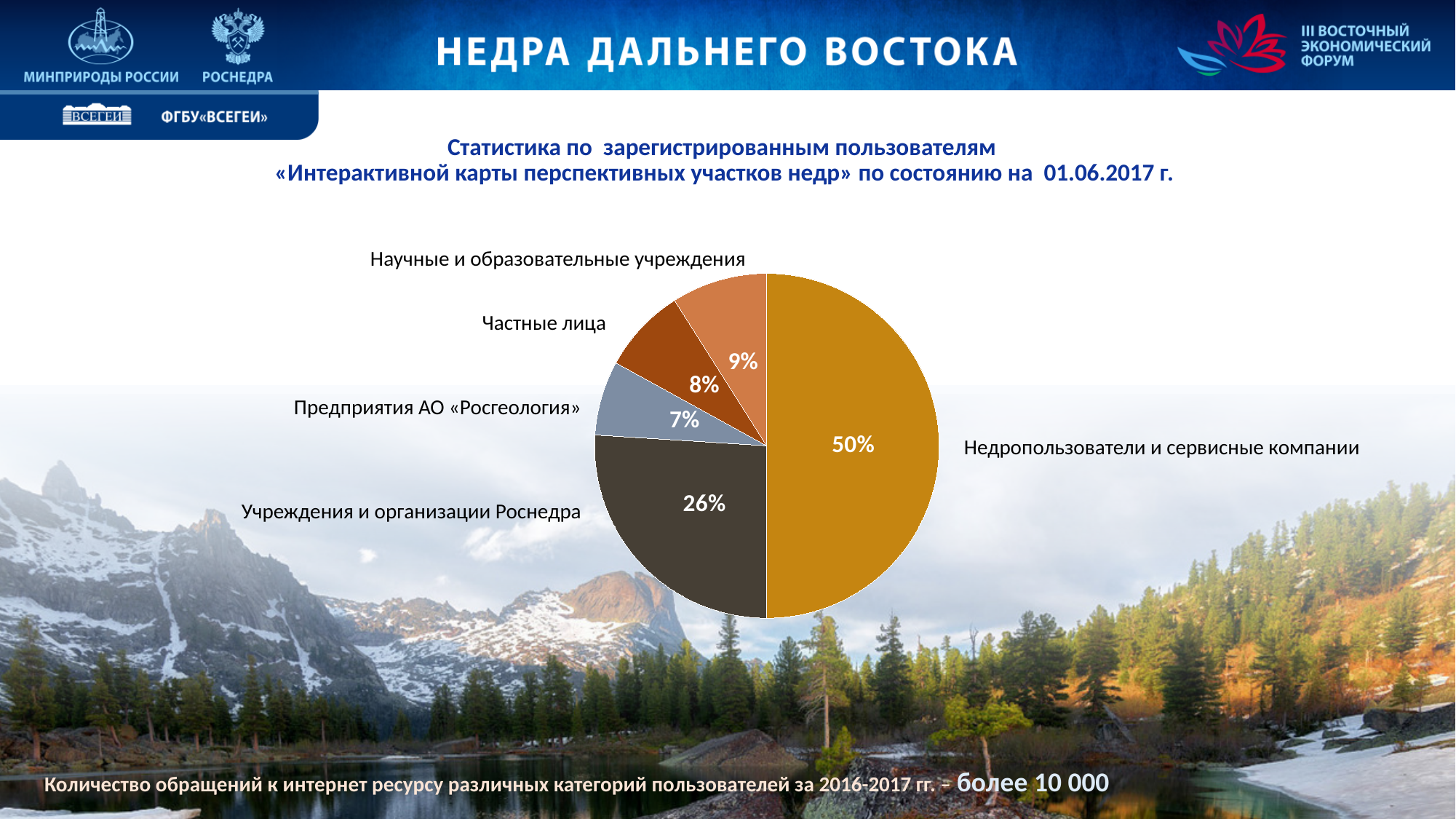
Which category has the smallest share of registered users? Предприятия АО «Росгеология» Which category has the largest share of registered users? Недропользователи и сервисные компании What date is the statistics on registered users given for, according to the chart title? 01.06.2017 What share of registered users are «Предприятия АО «Росгеология»»? 7% How many categories does the pie chart show? 5 What kind of chart is shown on the slide? Pie chart What share of registered users are «Научные и образовательные учреждения»? 9% Which has a larger share: «Частные лица» or «Научные и образовательные учреждения»? Научные и образовательные учреждения What share of registered users are «Недропользователи и сервисные компании»? 50% What is the difference in percentage points between «Недропользователи и сервисные компании» and «Учреждения и организации Роснедра»? 24%